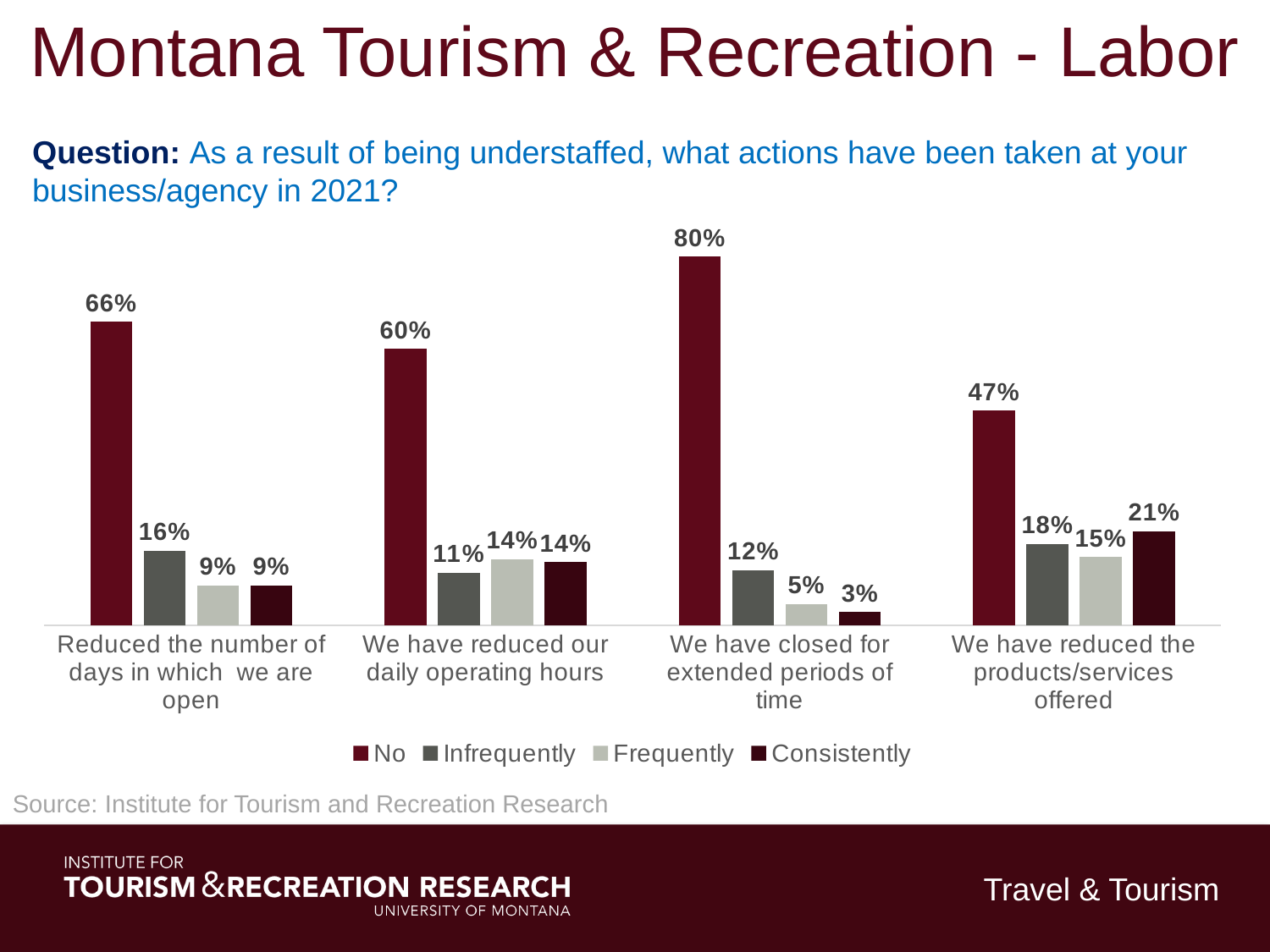
Which category has the highest "No" value? We have closed for extended periods of time What is the difference between the "No" values for "Reduced the number of days in which we are open" and "We have reduced our daily operating hours"? 6% How many series does the legend list? 4 What is the total of the four values for "We have reduced the products/services offered"? 101% Which is larger: the "Frequently" value for "We have reduced our daily operating hours" or for "We have closed for extended periods of time"? We have reduced our daily operating hours What percentage answered "No" for "We have closed for extended periods of time"? 80% Which category has the lowest "Consistently" value? We have closed for extended periods of time What kind of chart is shown on the slide? Bar chart How many categories are shown on the x axis? 4 What is the "Consistently" value for "We have reduced the products/services offered"? 21% What are the four legend entries? No, Infrequently, Frequently, Consistently What is the "Infrequently" value for "Reduced the number of days in which we are open"? 16%